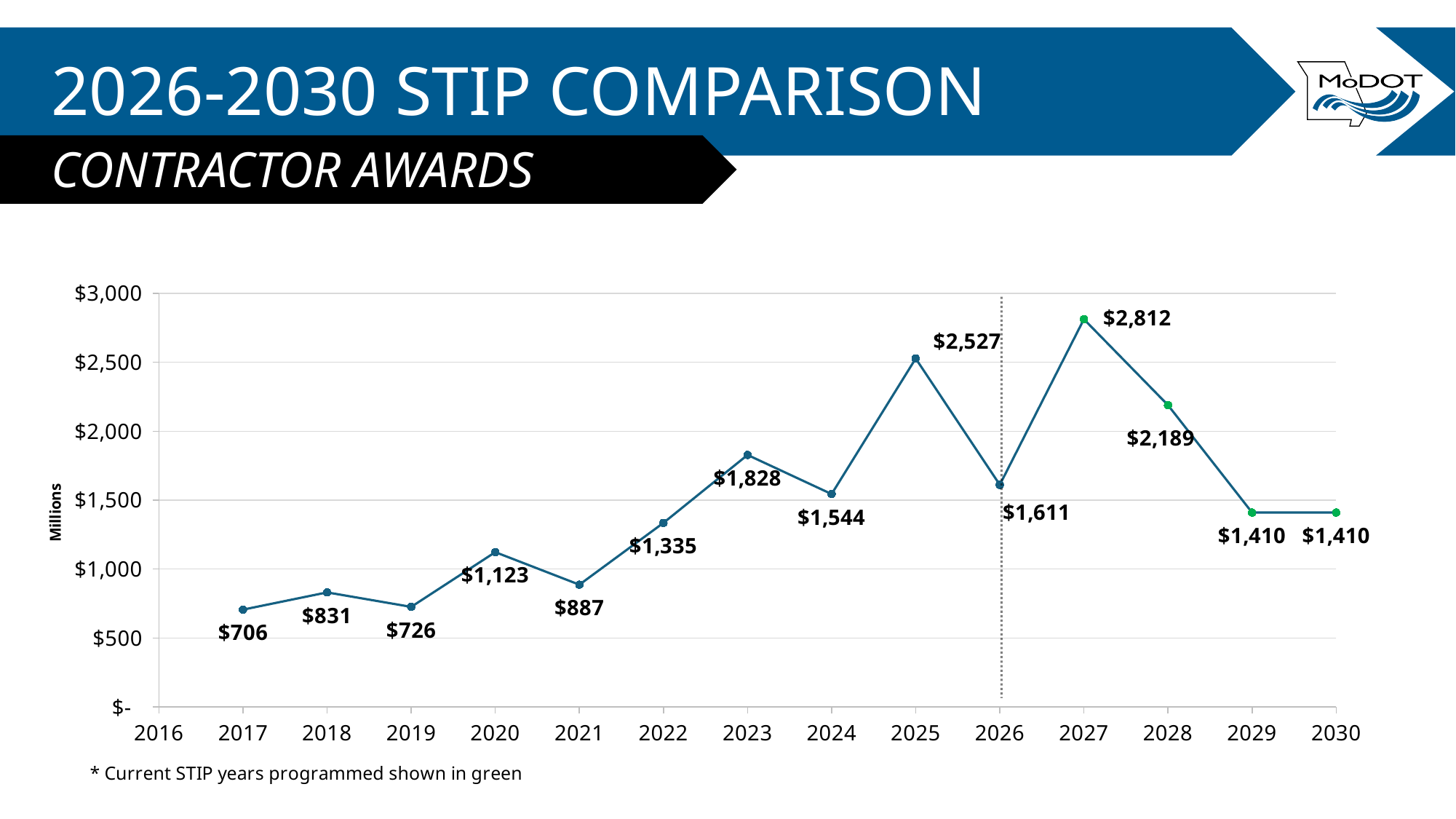
What is the contractor awards value for 2025? $2,527 Which year has the highest contractor awards value? 2027 What kind of chart is shown on the slide? line chart What is the contractor awards value for 2019? $726 Is the value for 2022 greater or less than $1,500? less How many years have data points plotted on the chart? 14 What unit is shown on the vertical axis label? Millions What is the contractor awards value for 2028? $2,189 What is the difference between the 2027 value and the 2026 value? $1,201 Which is larger, the value for 2023 or the value for 2024? 2023 Do the values rise or fall from 2027 to 2029? fall Which year has the lowest contractor awards value? 2017